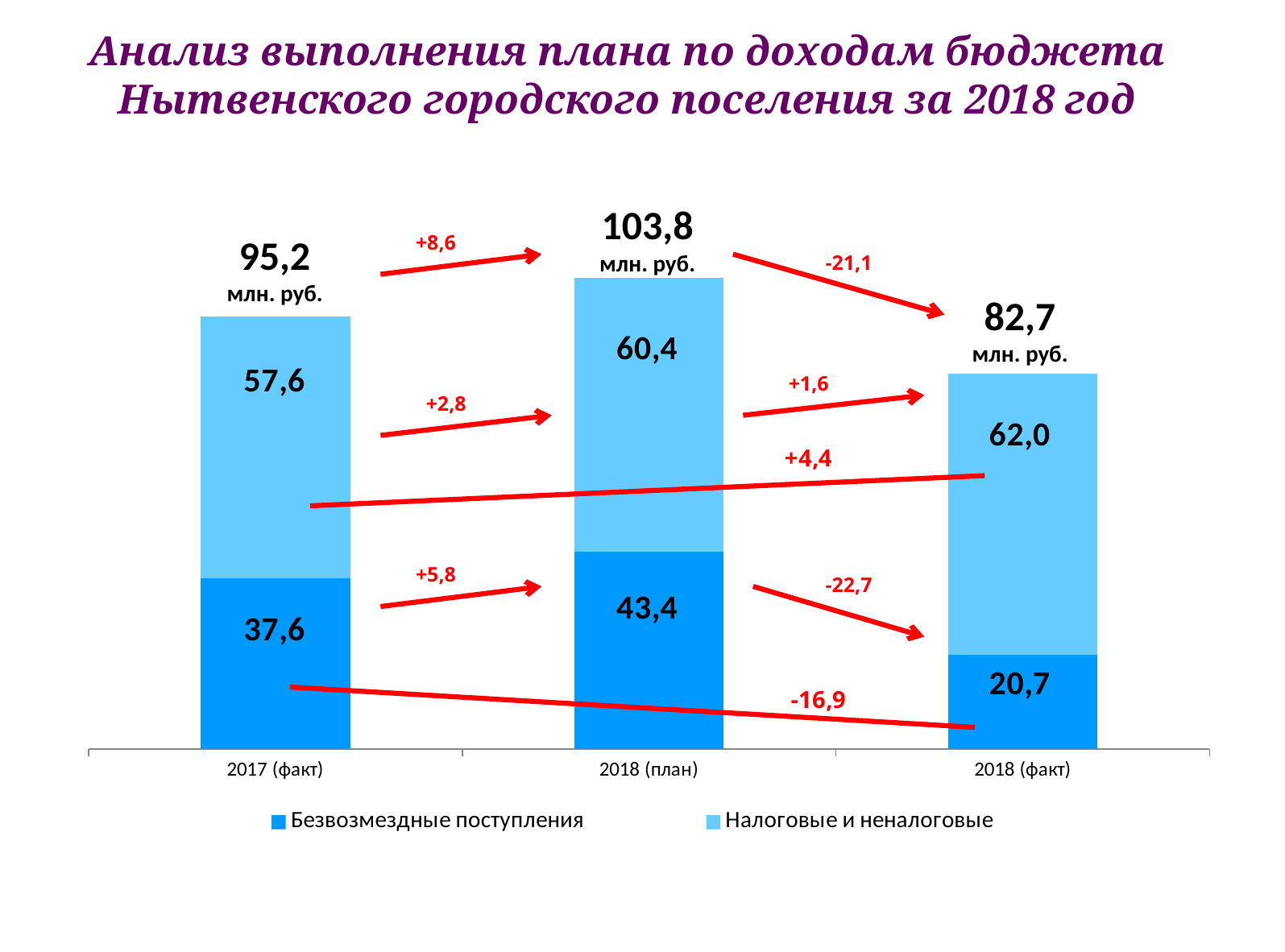
How many series does the legend list? 2 What is the difference between Безвозмездные поступления for 2018 (план) and 2018 (факт)? 22,7 Which is larger: Налоговые и неналоговые for 2018 (факт) or for 2018 (план)? 2018 (факт) What is the total of the stacked bar for 2018 (план)? 103,8 млн. руб. How many categories are shown on the x axis? 3 What is the value of Налоговые и неналоговые for 2018 (план)? 60,4 What kind of chart is shown on the slide? Stacked bar chart Which category has the lowest value for Налоговые и неналоговые? 2017 (факт) What is the value of Безвозмездные поступления for 2018 (факт)? 20,7 What is the value of Безвозмездные поступления for 2017 (факт)? 37,6 What is the total of the stacked bar for 2018 (факт)? 82,7 млн. руб. Which category has the highest value for Безвозмездные поступления? 2018 (план)